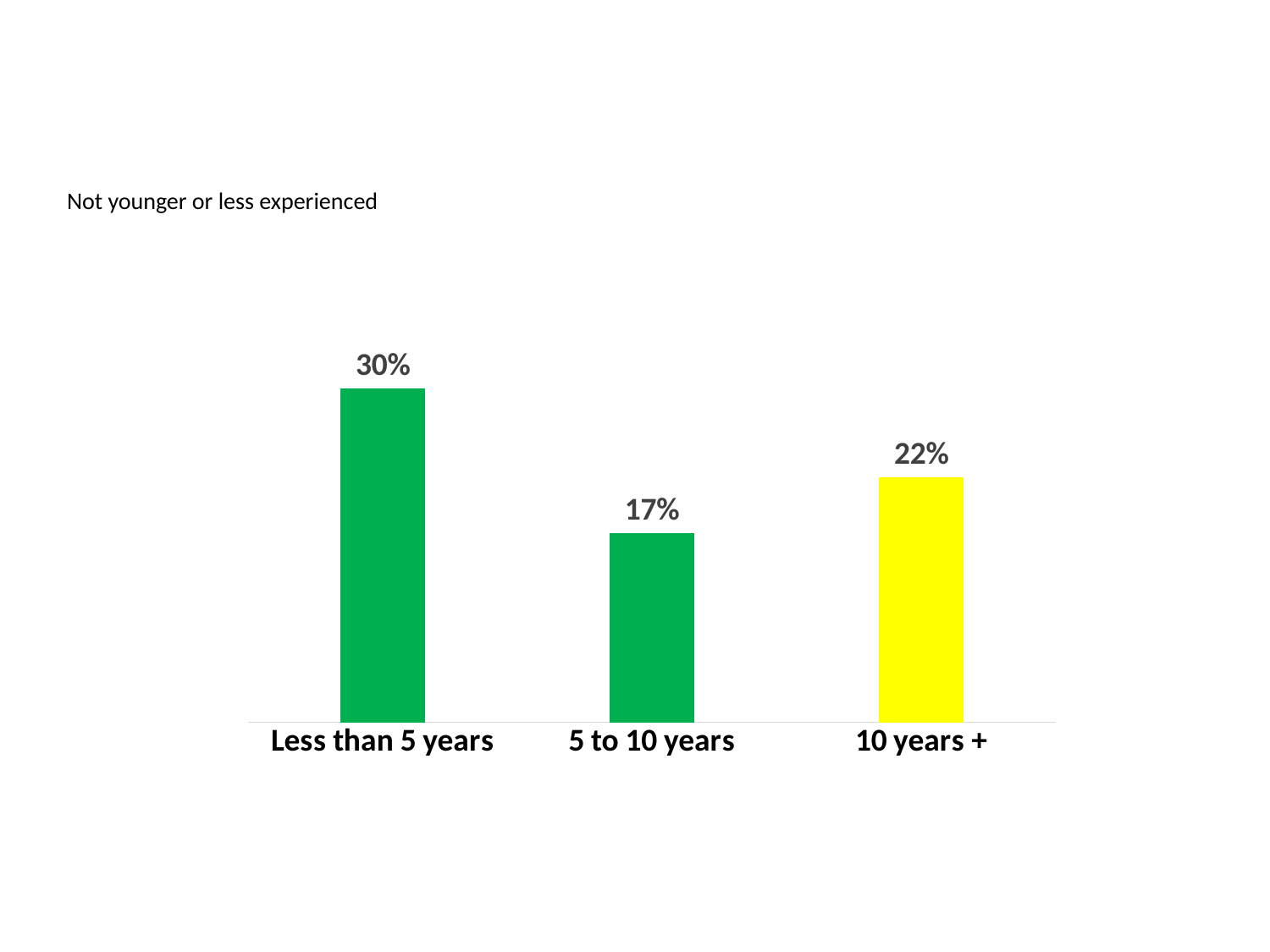
Which bar is coloured yellow? 10 years + What is the difference between the values for 10 years + and 5 to 10 years? 5% What kind of chart is shown on the slide? Bar chart What is the value for 10 years +? 22% Which is larger, the value for 10 years + or the value for 5 to 10 years? 10 years + What is the value for Less than 5 years? 30% Which category has the highest value? Less than 5 years What is the value for 5 to 10 years? 17% What is the difference between the values for Less than 5 years and 5 to 10 years? 13% How many categories are shown in the chart? 3 Which category has the lowest value? 5 to 10 years What text appears above the chart on the slide? Not younger or less experienced